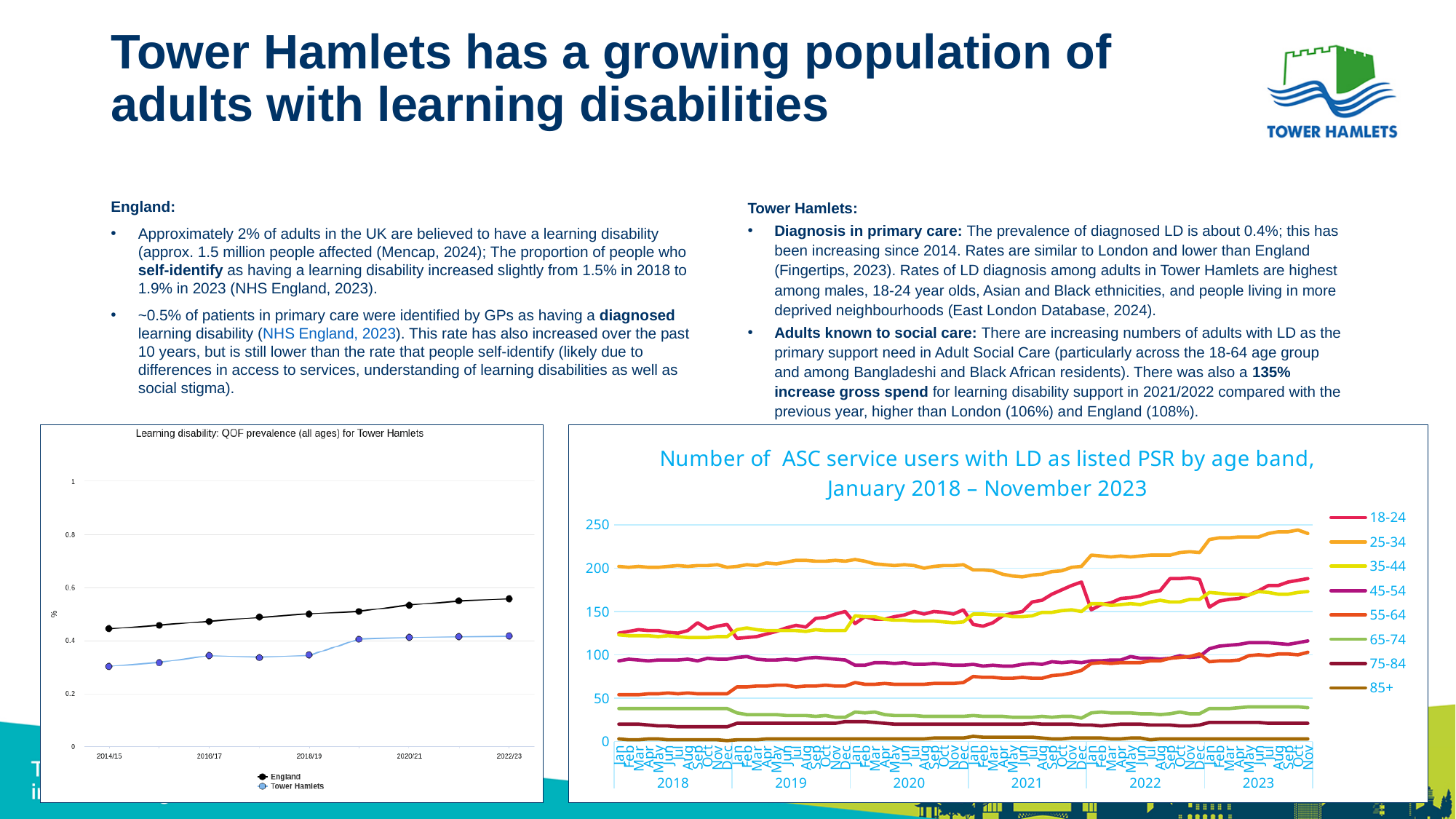
In the left chart (QOF prevalence), is the value for England in 2022/23 greater or less than 0.6? less In the right chart (ASC service users with LD by age band), which age band has the highest number of service users throughout the period? 25-34 In the left chart (QOF prevalence), is the value for Tower Hamlets in 2014/15 greater or less than 0.4? less In the left chart (QOF prevalence), which series is higher in 2022/23, England or Tower Hamlets? England In the right chart (ASC service users with LD by age band), is the value for 25-34 in Nov 2023 greater or less than 200? greater What type of chart is the left chart titled 'Learning disability: QOF prevalence (all ages) for Tower Hamlets'? Line chart In the right chart (ASC service users with LD by age band), which age band has the lowest number of service users throughout the period? 85+ How many series does the legend of the left chart (QOF prevalence) list? 2 In the left chart (QOF prevalence), does the Tower Hamlets line rise or fall from 2014/15 to 2022/23? Rises How many series does the legend of the right chart (ASC service users with LD by age band) list? 8 In the right chart (ASC service users with LD by age band), does the 18-24 line generally rise or fall from 2018 to 2023? Rises In the right chart (ASC service users with LD by age band), which is larger in Jan 2018, the 45-54 band or the 55-64 band? 45-54